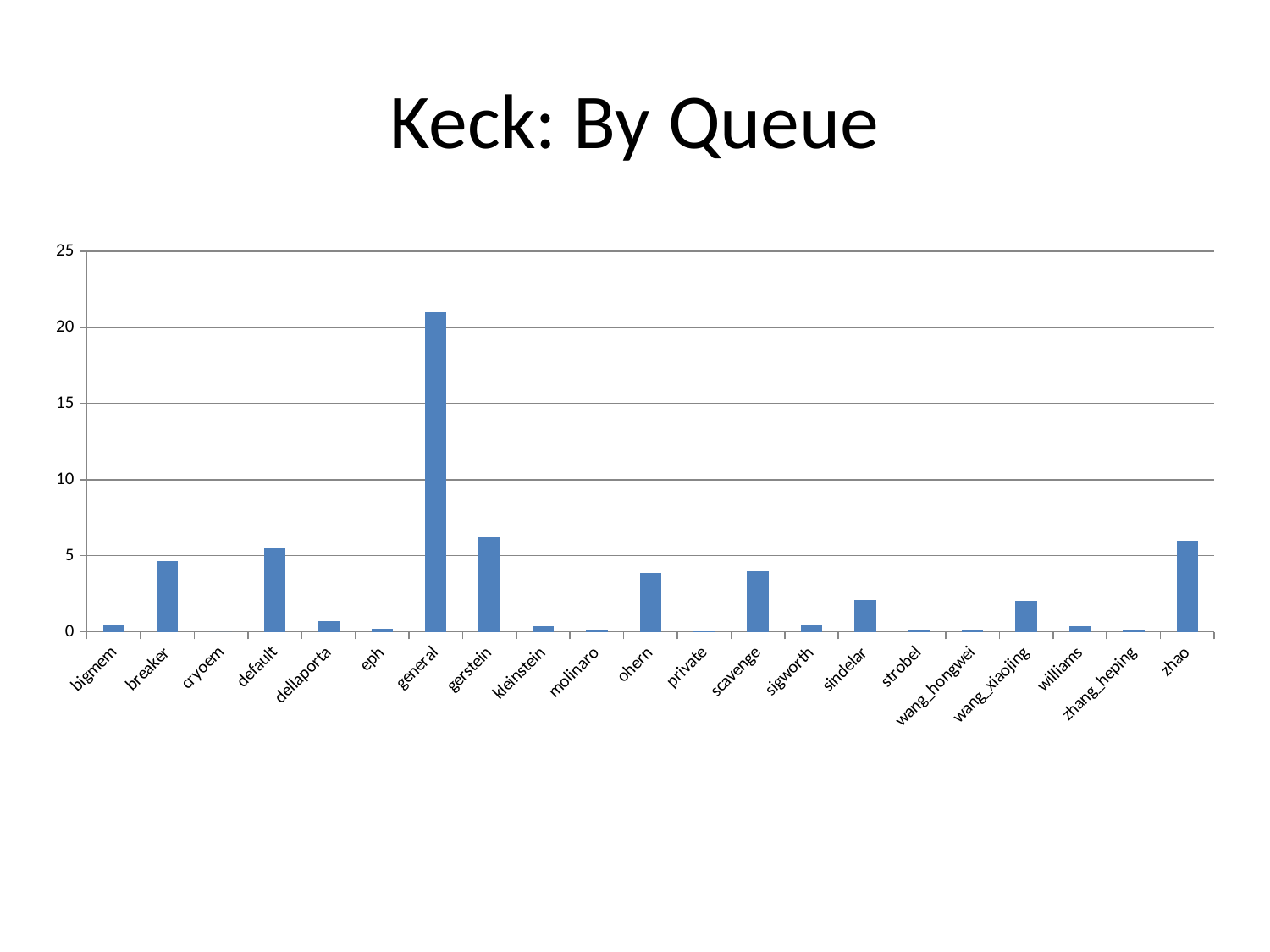
Which queue has the highest value? general Is the value for ohern greater or less than 5? less What is the title of the chart? Keck: By Queue Is the value for gerstein greater or less than 5? greater How many queues (categories) are shown on the x axis? 21 Is the value for general greater or less than 20? greater Which is larger, the value for general or the value for zhao? general Which is larger, the value for default or the value for sindelar? default What kind of chart is shown on the slide? bar chart Which is larger, the value for gerstein or the value for breaker? gerstein